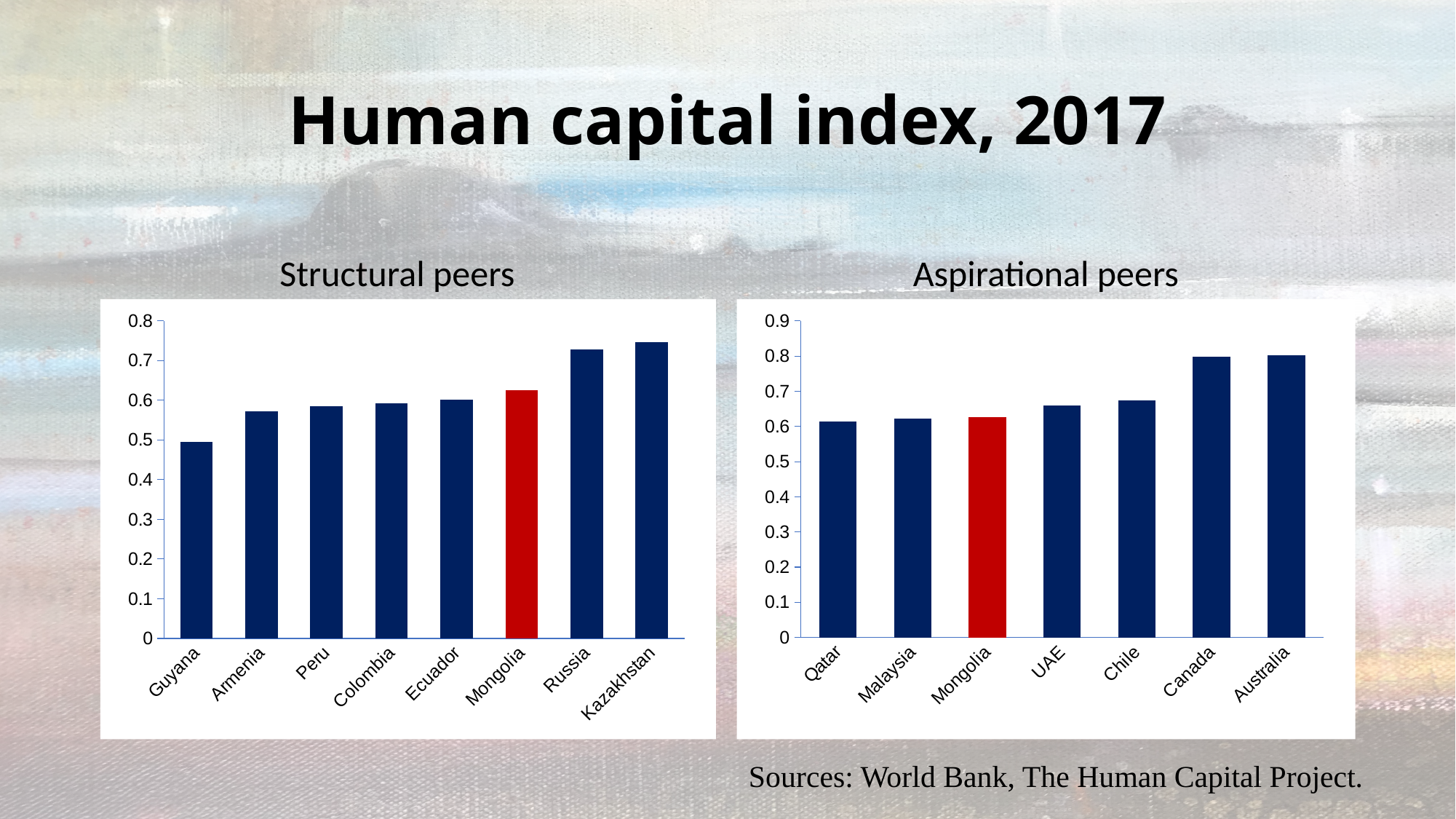
In the Structural peers chart, is the value for Russia greater or less than 0.7? greater Which country's bar is coloured red in both charts? Mongolia In the Structural peers chart, is the value for Armenia greater or less than 0.6? less How many countries are shown in the Structural peers chart? 8 How many countries are shown in the Aspirational peers chart? 7 In the Aspirational peers chart, is the value for Canada greater or less than 0.7? greater In the Aspirational peers chart, do the values generally rise or fall from left to right? rise In the Structural peers chart, which is larger, the value for Kazakhstan or the value for Mongolia? Kazakhstan What kind of chart is the Structural peers chart? bar chart In the Aspirational peers chart, which is larger, the value for Qatar or the value for Australia? Australia In the Structural peers chart, which country has the lowest human capital index? Guyana